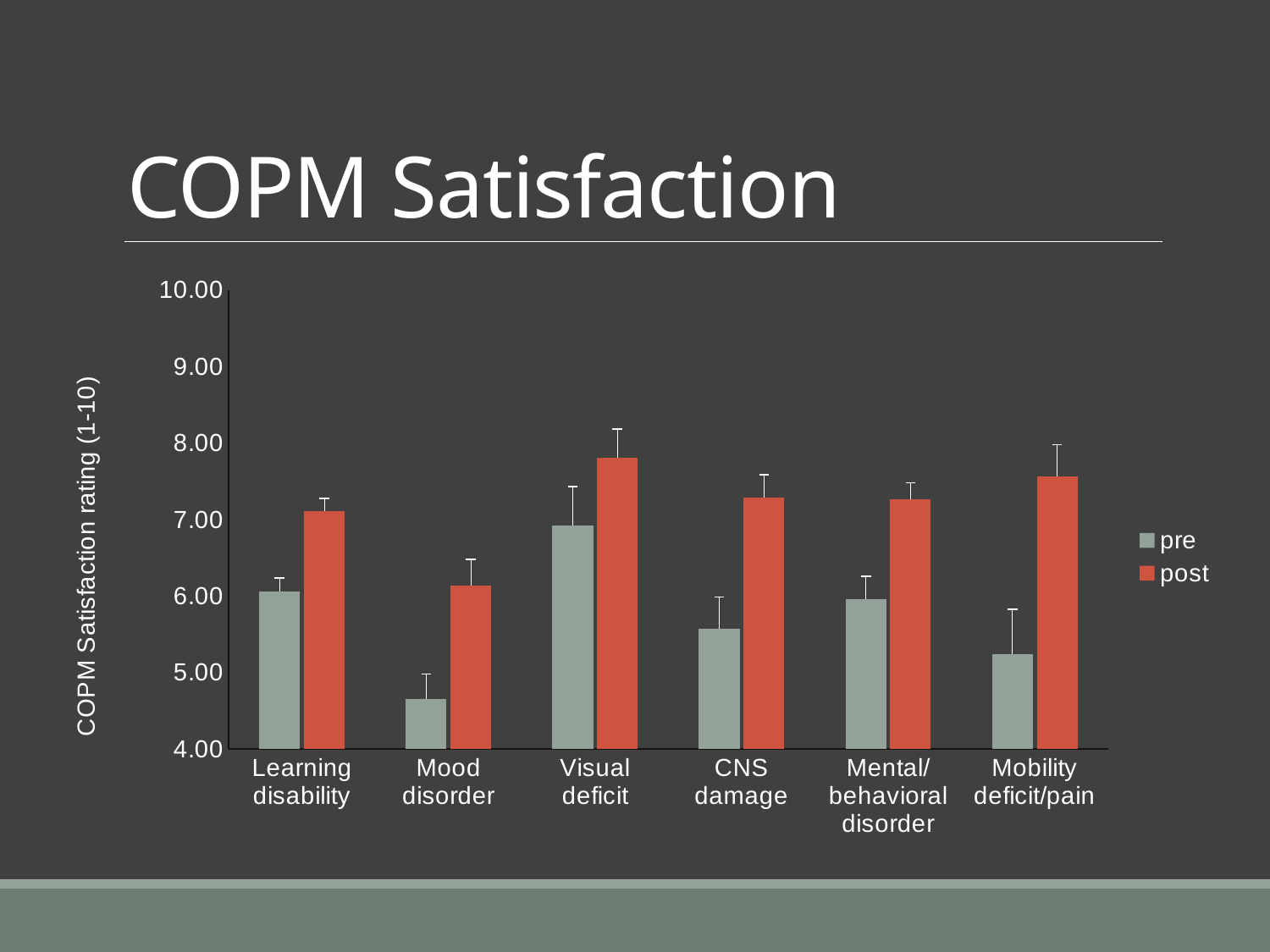
What is the label of the y axis? COPM Satisfaction rating (1-10) Which category has the lowest post value? Mood disorder Which category has the highest pre value? Visual deficit Is the pre value for Mood disorder greater or less than 5.00? less Which category has the lowest pre value? Mood disorder What kind of chart is shown on the slide? bar chart Is the post value for Mobility deficit/pain greater or less than 7.00? greater Is the post value for Visual deficit greater or less than 7.00? greater How many series does the legend list? 2 How many categories are shown on the x axis? 6 For Mobility deficit/pain, which is larger, the pre value or the post value? post